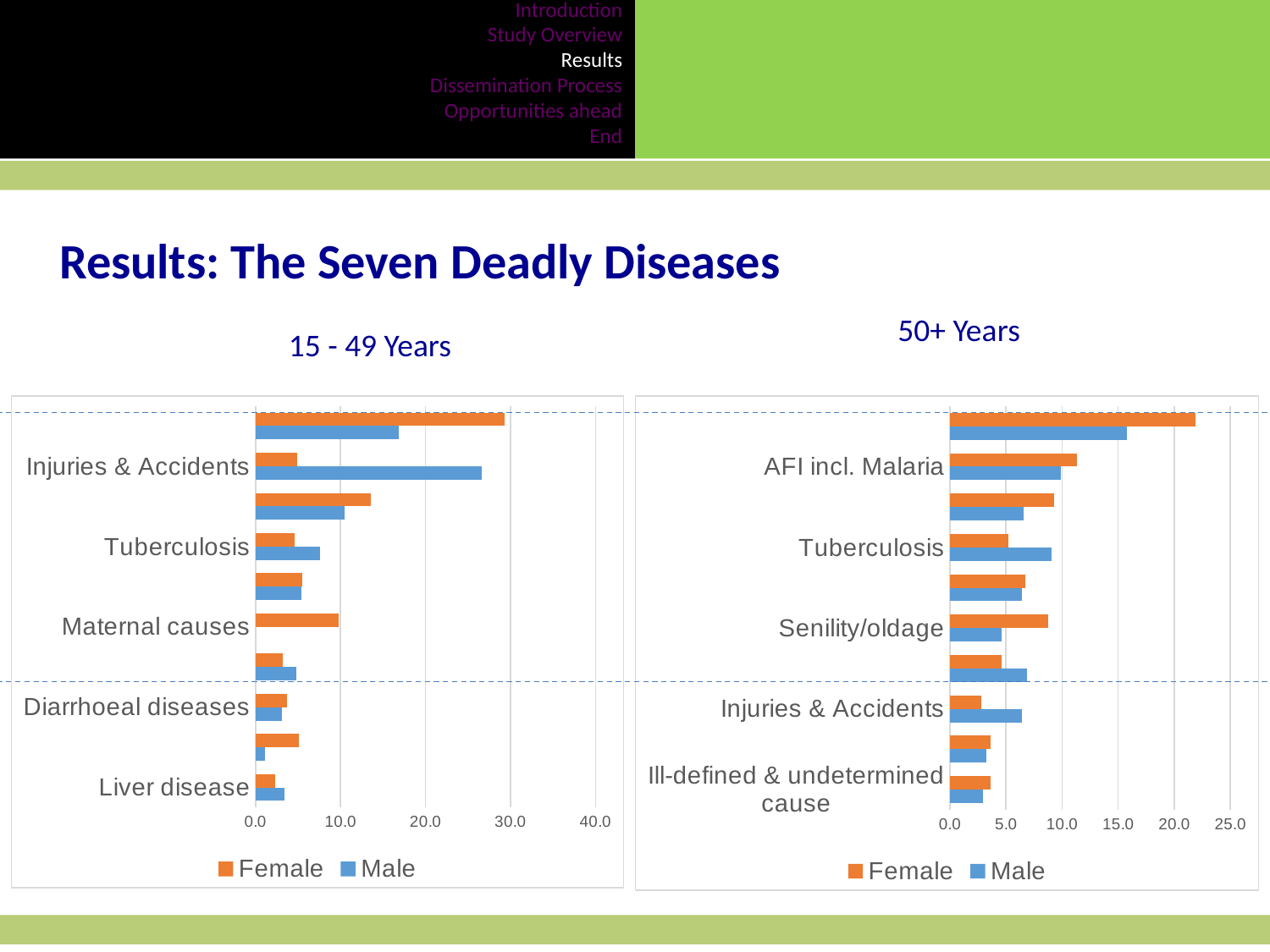
What are the two legend entries in the "15 - 49 Years" chart? Female and Male In the "50+ Years" chart, which series is larger for Tuberculosis, Female or Male? Male In the "50+ Years" chart, what colour are the Female bars? orange How many series does the legend of the "50+ Years" chart list? 2 In the "15 - 49 Years" chart, is the Male value for Tuberculosis greater or less than 10.0? less In the "15 - 49 Years" chart, is the Male value for Injuries & Accidents greater or less than 20.0? greater In the "50+ Years" chart, which series is larger for Senility/oldage, Female or Male? Female In the "50+ Years" chart, is the Female value for AFI incl. Malaria greater or less than 5.0? greater What kind of chart is the "15 - 49 Years" chart? bar chart In the "15 - 49 Years" chart, which series is larger for Maternal causes, Female or Male? Female